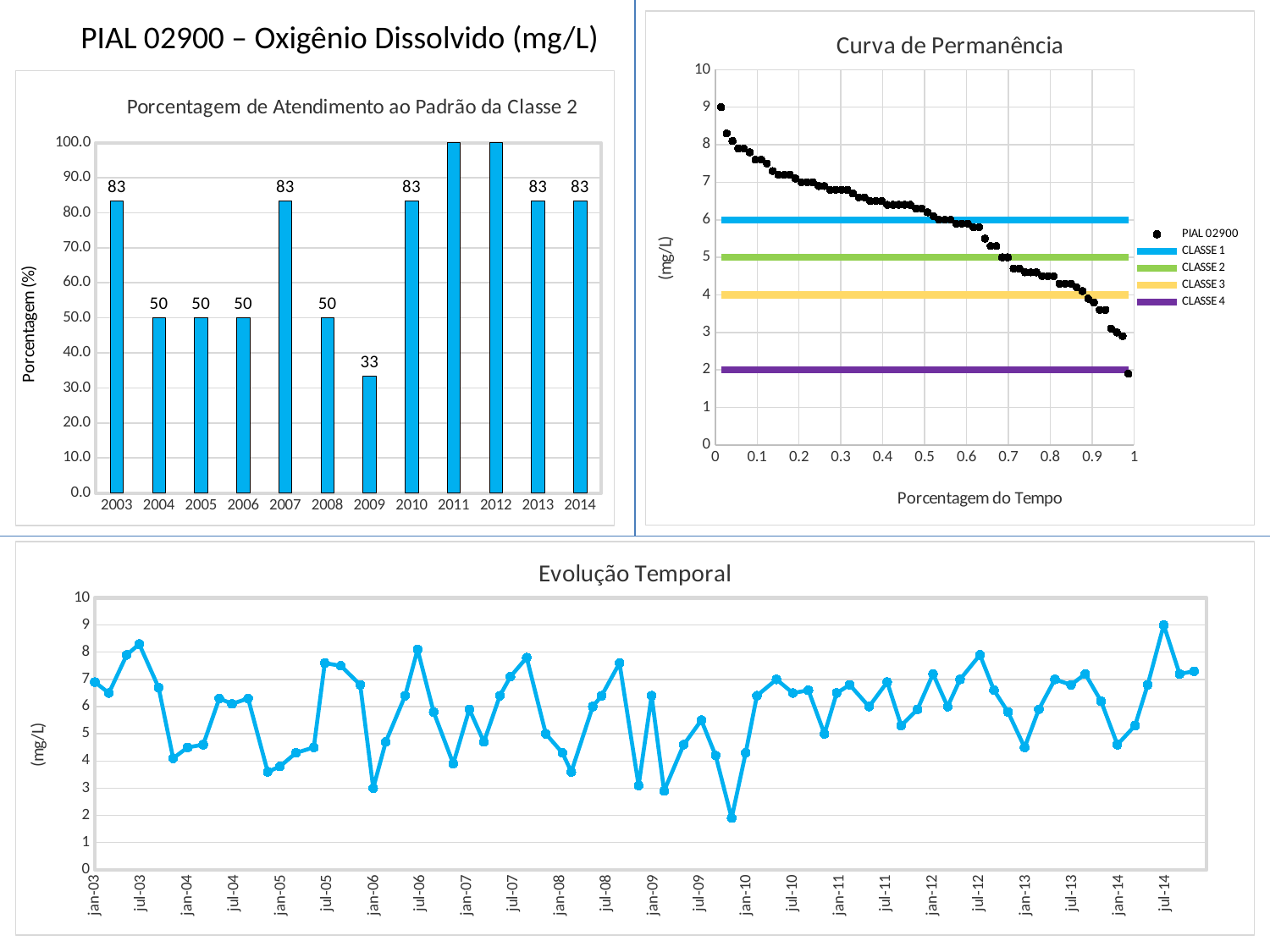
How many years are shown in the chart 'Porcentagem de Atendimento ao Padrão da Classe 2'? 12 In the chart 'Porcentagem de Atendimento ao Padrão da Classe 2', which is larger, the value for 2007 or the value for 2008? 2007 In the chart 'Porcentagem de Atendimento ao Padrão da Classe 2', which years have the highest value? 2011 and 2012 In the chart 'Porcentagem de Atendimento ao Padrão da Classe 2', what is the value for 2009? 33 In the chart 'Evolução Temporal', is the value for jan-06 greater or less than 4? less In the chart 'Porcentagem de Atendimento ao Padrão da Classe 2', what is the value for 2003? 83 In the chart 'Porcentagem de Atendimento ao Padrão da Classe 2', which year has the lowest value? 2009 In the chart 'Porcentagem de Atendimento ao Padrão da Classe 2', what is the difference between the values for 2003 and 2009? 50 How many series does the legend of the chart 'Curva de Permanência' list? 5 In the chart 'Curva de Permanência', at which mg/L level is the CLASSE 1 line drawn? 6 What kind of chart is 'Evolução Temporal'? line chart What kind of chart is 'Porcentagem de Atendimento ao Padrão da Classe 2'? bar chart